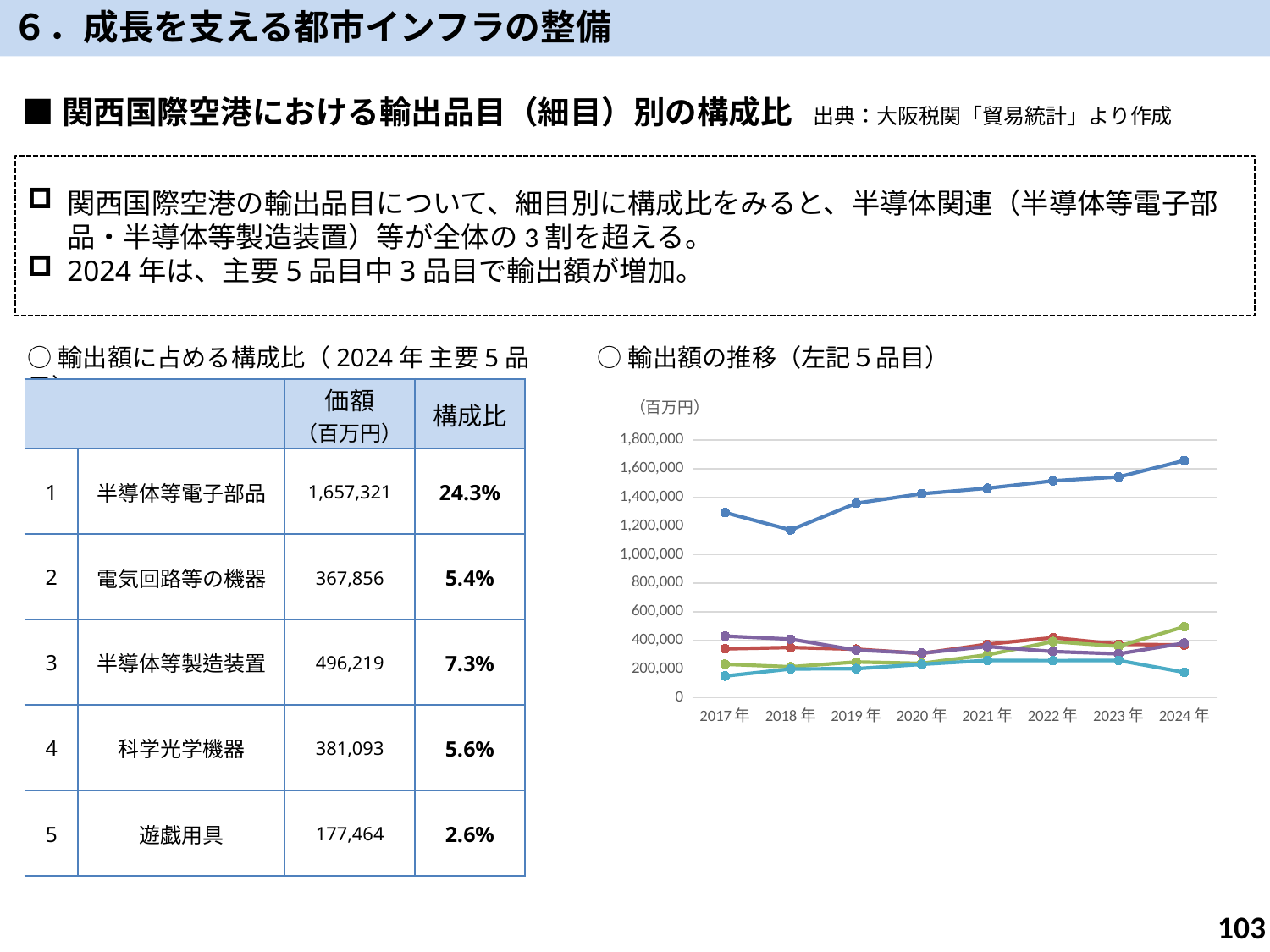
In the 「輸出額の推移」 chart, which is larger in 2024年: the top (blue) line or the green line? the blue line In the 「輸出額の推移」 chart, in which year does the top (blue) line reach its highest value? 2024年 In the 「輸出額の推移」 chart, is the value of the top (blue) line in 2022年 greater or less than 1,400,000? greater In the 「輸出額の推移」 chart, does the top (blue) line rise or fall from 2019年 to 2024年? rise What unit is shown above the y axis of the 「輸出額の推移」 chart? （百万円） What kind of chart is shown under 「輸出額の推移（左記5品目）」? line chart In the 「輸出額の推移」 chart, is the value of the green line in 2024年 greater or less than 400,000? greater In the 「輸出額の推移」 chart, how many lines are plotted? 5 In the 「輸出額の推移」 chart, is the value of the top (blue) line in 2024年 greater or less than 1,600,000? greater In the 「輸出額の推移」 chart, in which year does the top (blue) line reach its lowest value? 2018年 In the 「輸出額の推移」 chart, how many years are shown on the x axis? 8